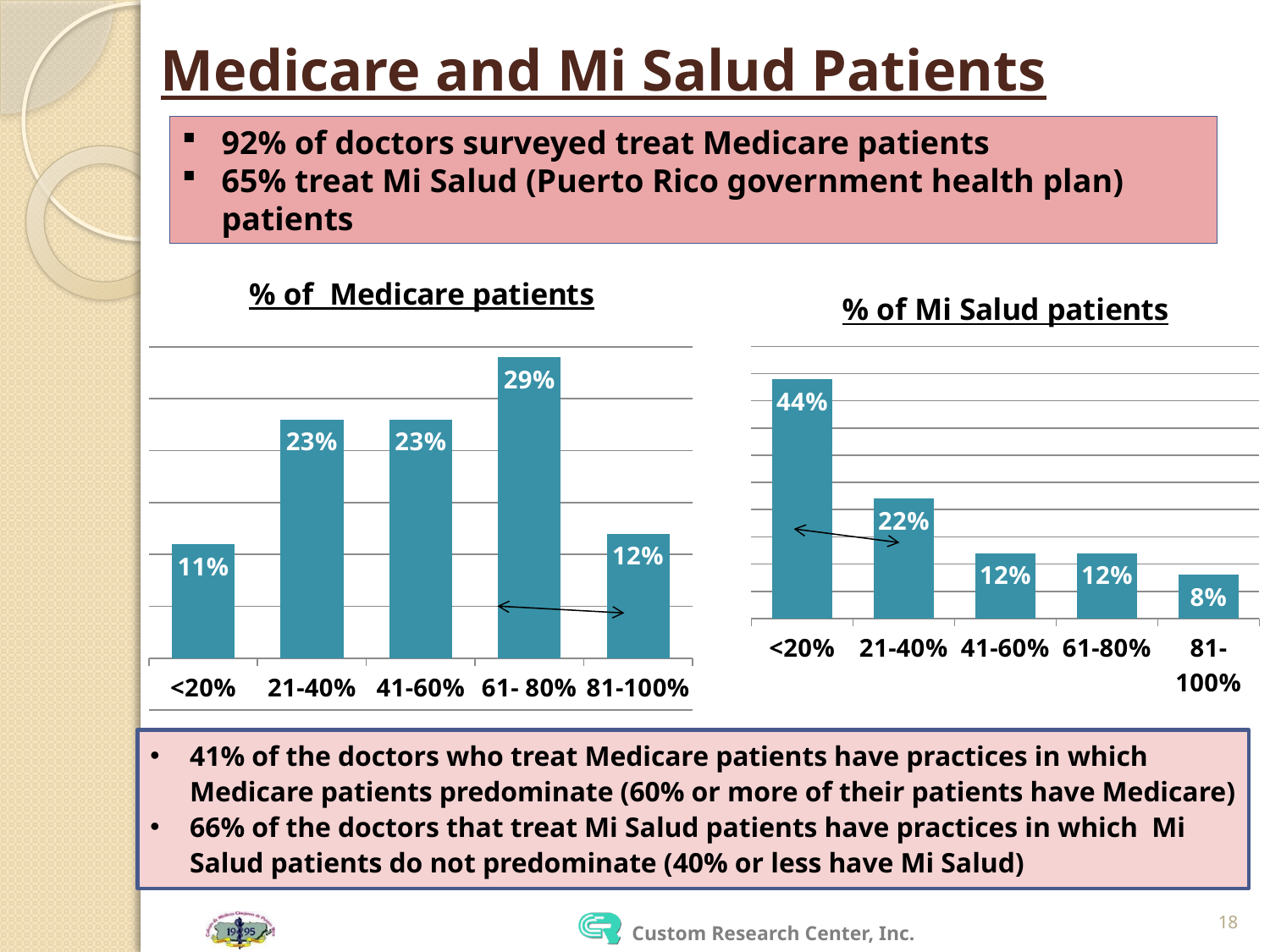
In the '% of Medicare patients' chart, which category has the lowest value? <20% What type of chart is the '% of Medicare patients' chart? Bar chart In the '% of Mi Salud patients' chart, what is the value for the <20% category? 44% In the '% of Mi Salud patients' chart, do the values generally rise or fall from left to right? Fall In the '% of Medicare patients' chart, what is the value for the 61-80% category? 29% In the '% of Mi Salud patients' chart, which category has the lowest value? 81-100% In the '% of Mi Salud patients' chart, which category has the highest value? <20% In the '% of Mi Salud patients' chart, what is the difference between the <20% and 21-40% values? 22% In the '% of Medicare patients' chart, which is larger: the value for 21-40% or the value for 81-100%? 21-40% What is the title of the chart on the right side of the slide? % of Mi Salud patients How many categories are shown in the '% of Mi Salud patients' chart? 5 In the '% of Medicare patients' chart, what is the difference between the 61-80% and 81-100% values? 17%